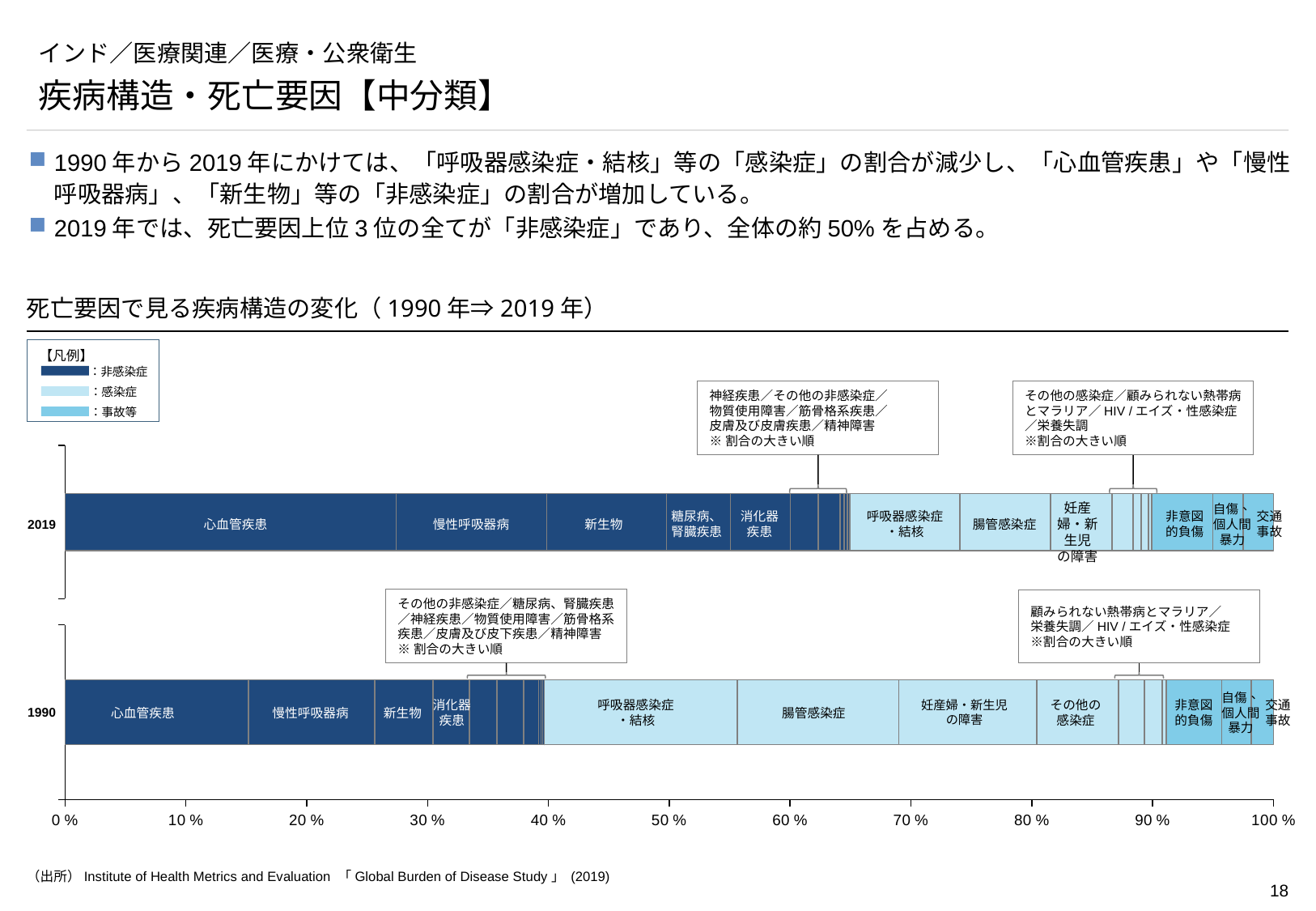
What kind of chart is shown on the slide? Stacked bar chart How many categories (years) are plotted as bars in the chart? 2 What is the title of the chart? 死亡要因で見る疾病構造の変化（1990年⇒2019年） Which year has the larger share of 呼吸器感染症・結核, 1990 or 2019? 1990 Is the share of 心血管疾患 in 2019 greater or less than 20%? greater Which cause of death has the largest share in the 2019 bar? 心血管疾患 Which year has the larger share of 心血管疾患, 1990 or 2019? 2019 How many entries does the chart legend (凡例) list? 3 Is the share of 慢性呼吸器病 in 2019 greater or less than 10%? greater Is the share of 呼吸器感染症・結核 in 1990 greater or less than 10%? greater Which legend category is shown in the darkest blue colour? 非感染症